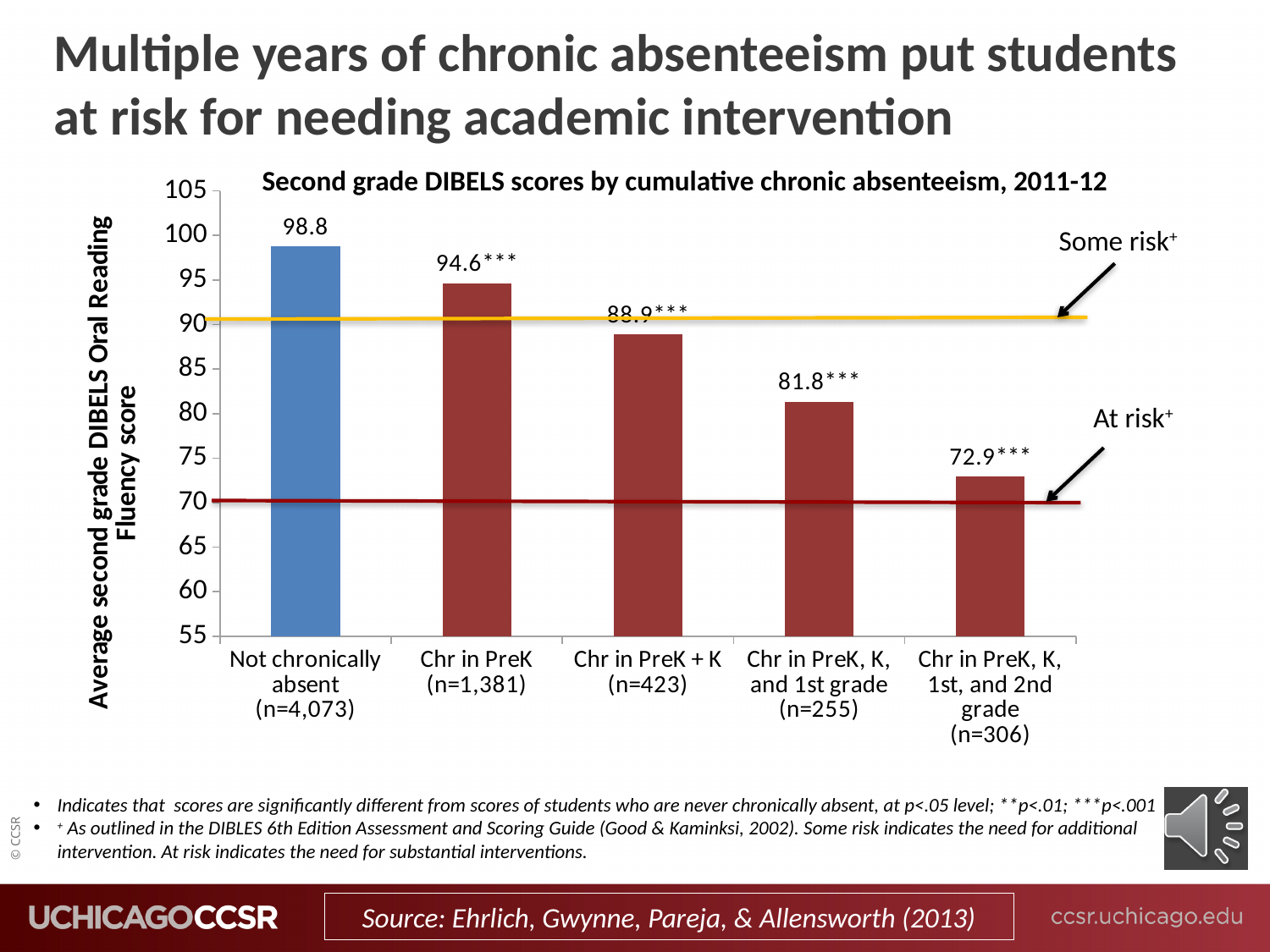
What type of chart is shown on the slide? Bar chart Which group has a higher average DIBELS score: Chr in PreK or Chr in PreK + K? Chr in PreK Is the average DIBELS score for the Chr in PreK, K, and 1st grade group greater or less than 85? less What is the difference in average DIBELS score between students not chronically absent and those chronically absent in PreK, K, 1st, and 2nd grade? 25.9 What is the average DIBELS score for students chronically absent in PreK, K, 1st, and 2nd grade? 72.9 What is the average DIBELS Oral Reading Fluency score for students who were not chronically absent? 98.8 Which category has the lowest average DIBELS score? Chr in PreK, K, 1st, and 2nd grade What is the average DIBELS score for students chronically absent in PreK + K? 88.9 What is the difference in average DIBELS score between the Chr in PreK group and the Chr in PreK, K, and 1st grade group? 12.8 How many absenteeism categories are shown on the x axis? 5 Do the average DIBELS scores rise or fall as cumulative chronic absenteeism increases along the x axis? Fall Which category has the highest average DIBELS score? Not chronically absent